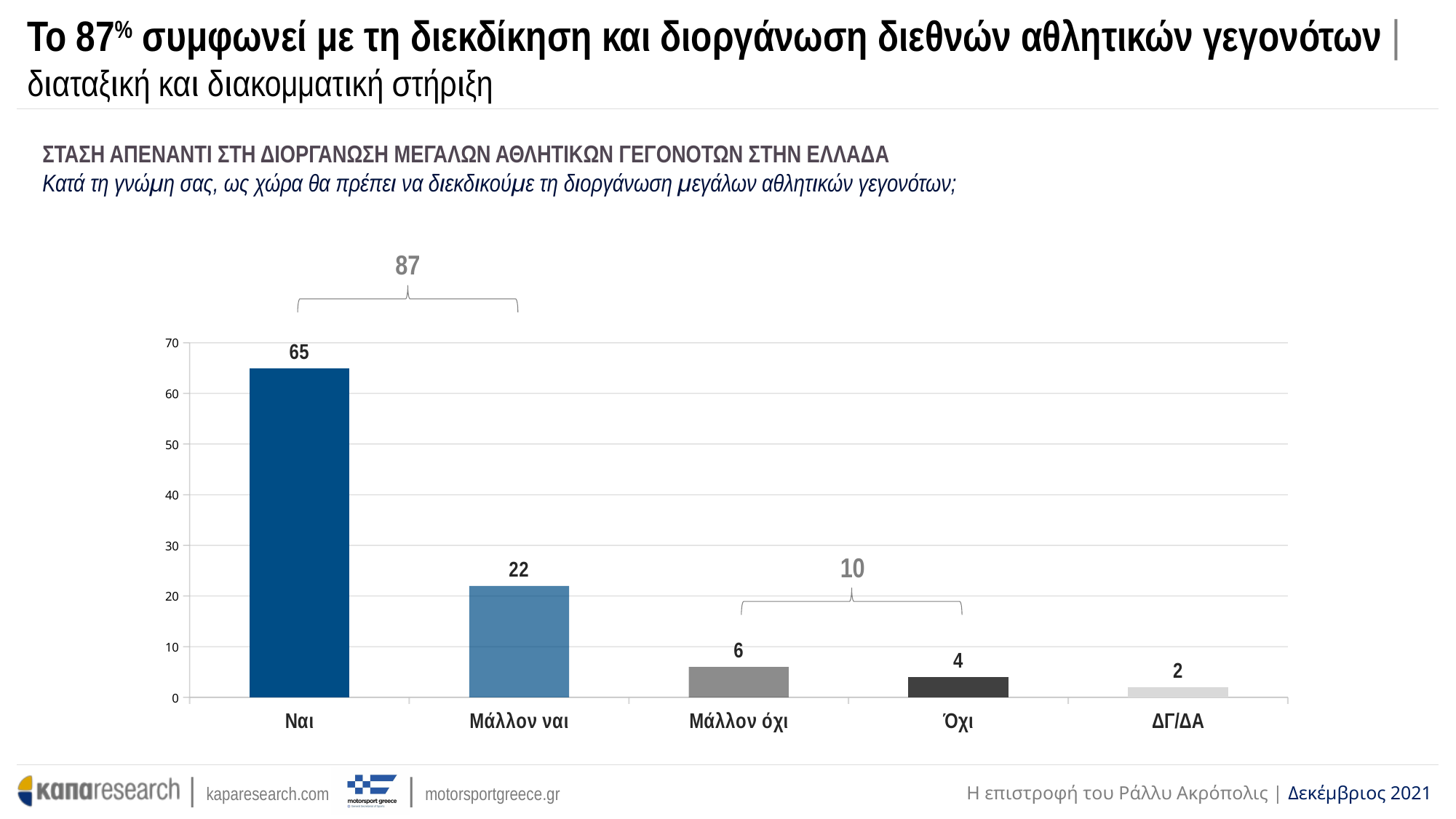
How many categories are shown on the x axis? 5 What is the difference between the values for Ναι and Μάλλον ναι? 43 Which is larger, the value for Μάλλον όχι or the value for Όχι? Μάλλον όχι Which category has the lowest value? ΔΓ/ΔΑ What combined value does the bracket above Μάλλον όχι and Όχι show? 10 Is the value for Ναι greater or less than 60? greater What kind of chart is shown on the slide? bar chart What is the value for Μάλλον όχι? 6 What is the value for ΔΓ/ΔΑ? 2 What is the value for Μάλλον ναι? 22 Which category has the highest value? Ναι What is the value for Ναι? 65